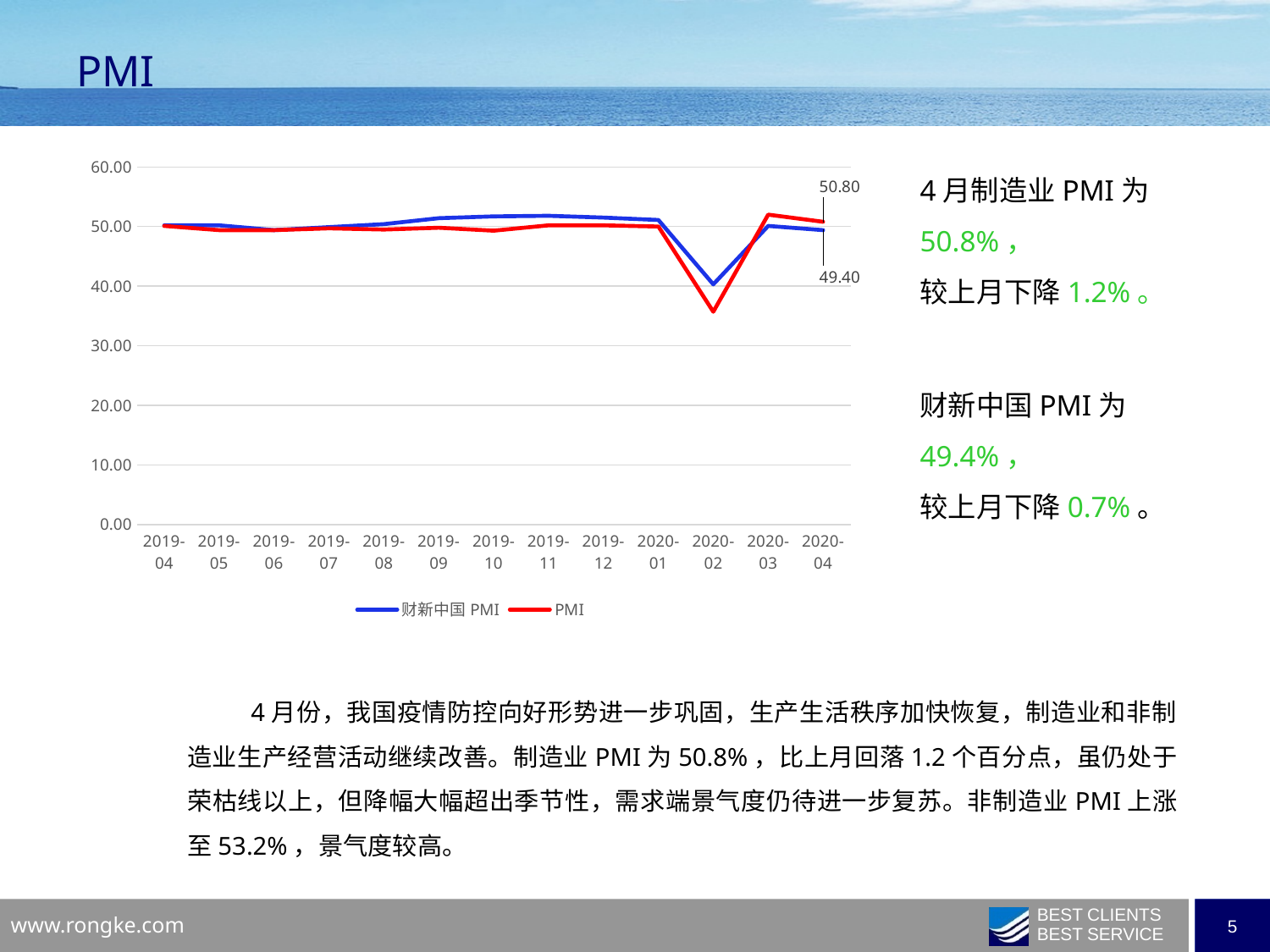
At 2020-04, which series has the higher value, PMI or 财新中国 PMI? PMI What is the value of the PMI series at 2020-04? 50.80 How many series does the chart's legend list? 2 Is the value of the PMI series at 2020-02 greater or less than 40? less What is the value of the 财新中国 PMI series at 2020-04? 49.40 What colour is the line for the PMI series in the chart? red At which month does the PMI series reach its lowest point? 2020-02 Is the value of the 财新中国 PMI series at 2020-02 greater or less than 50? less Between 2020-02 and 2020-03, does the PMI series rise or fall? rise What is the difference between the PMI value and the 财新中国 PMI value at 2020-04? 1.40 What kind of chart is shown on the slide? line chart How many time points are shown on the x axis of the chart? 13